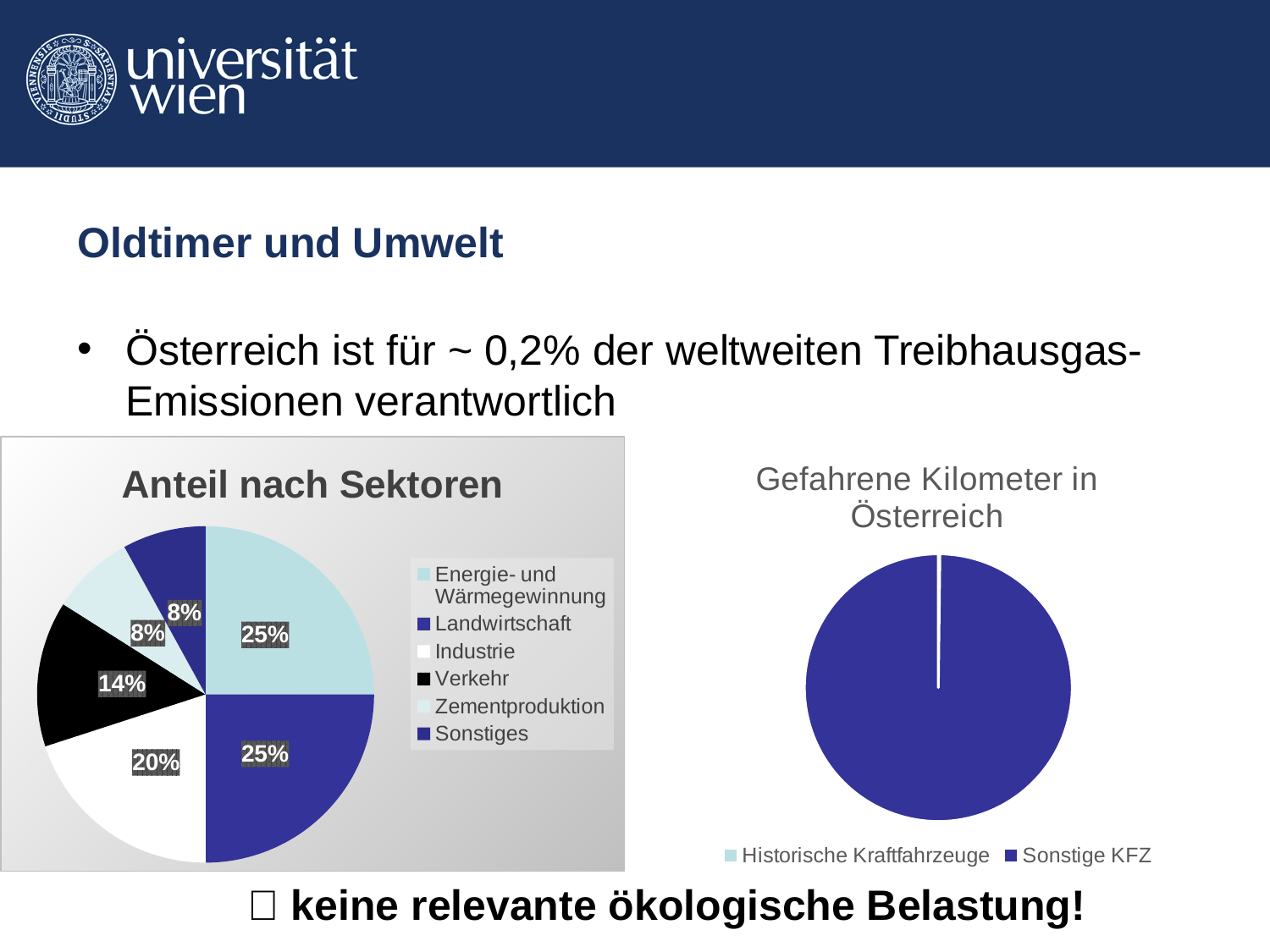
In the 'Anteil nach Sektoren' chart, what is the difference between the shares of Industrie and Verkehr? 6% What kind of chart is 'Anteil nach Sektoren'? Pie chart In the 'Anteil nach Sektoren' chart, what is the combined share of Energie- und Wärmegewinnung and Landwirtschaft? 50% How many entries does the legend of the 'Gefahrene Kilometer in Österreich' chart list? 2 In the 'Gefahrene Kilometer in Österreich' chart, which category has the larger share, Historische Kraftfahrzeuge or Sonstige KFZ? Sonstige KFZ How many sectors are shown in the 'Anteil nach Sektoren' chart? 6 In the 'Anteil nach Sektoren' chart, what share does Landwirtschaft have? 25% In the 'Anteil nach Sektoren' chart, what share does Industrie have? 20% In the 'Anteil nach Sektoren' chart, which has the larger share, Industrie or Verkehr? Industrie In the 'Anteil nach Sektoren' chart, what share does Verkehr have? 14% In the 'Anteil nach Sektoren' chart, what share does Zementproduktion have? 8% What is the title of the pie chart on the right side of the slide? Gefahrene Kilometer in Österreich